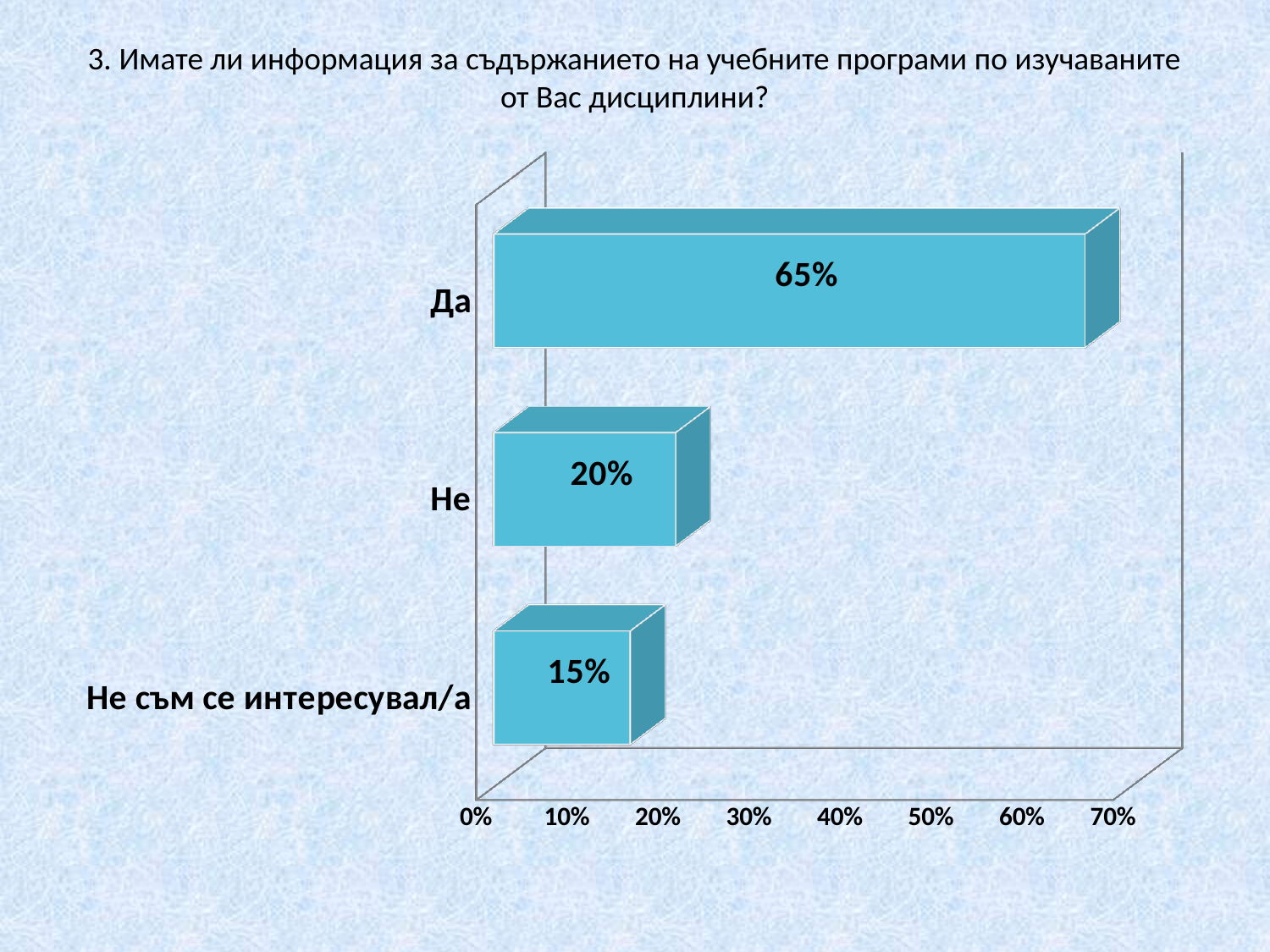
What is the maximum value shown on the horizontal axis? 70% What is the difference between the values for "Да" and "Не"? 45% What is the value for "Не съм се интересувал/а"? 15% Which category has the highest value? Да What kind of chart is shown on the slide? bar chart Is the value for "Да" greater or less than 50%? greater What is the value for "Да"? 65% Which is larger, the value for "Не" or the value for "Не съм се интересувал/а"? Не Which category has the lowest value? Не съм се интересувал/а What is the difference between the values for "Не" and "Не съм се интересувал/а"? 5% How many categories are shown in the chart? 3 What is the value for "Не"? 20%